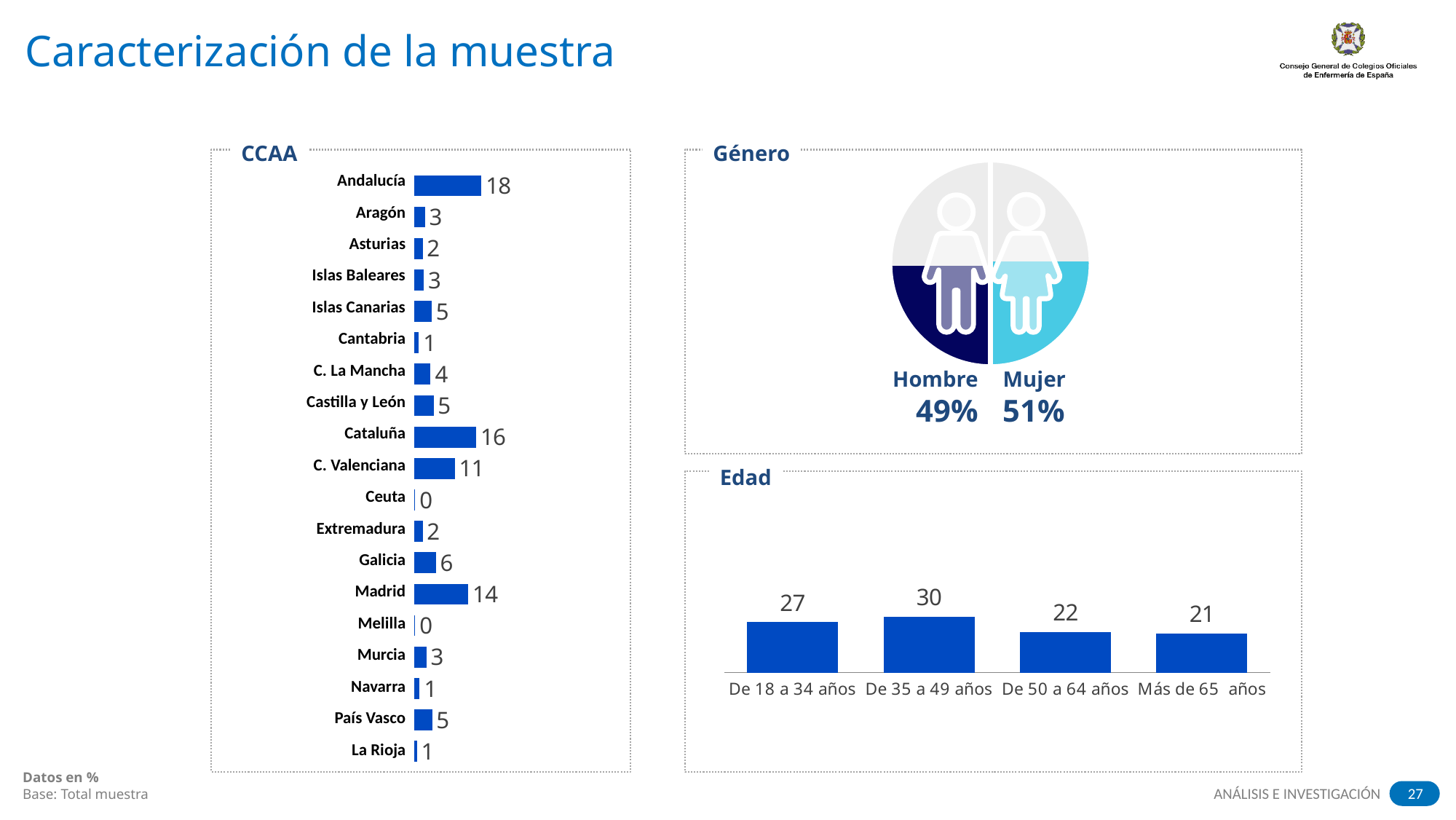
In the CCAA chart, what is the value for Madrid? 14 In the Género chart, which is larger, Hombre or Mujer? Mujer In the Edad chart, which category has the lowest value? Más de 65 años In the Edad chart, what is the value for De 35 a 49 años? 30 In the Edad chart, what is the difference between De 18 a 34 años and De 50 a 64 años? 5 In the Género chart, what is the value for Mujer? 51% In the CCAA chart, what is the difference between Cataluña and C. Valenciana? 5 In the CCAA chart, which is larger, Galicia or Islas Canarias? Galicia In the CCAA chart, which category has the highest value? Andalucía In the CCAA chart, how many categories are shown? 19 What kind of chart is the CCAA chart? Bar chart In the CCAA chart, what is the value for Andalucía? 18